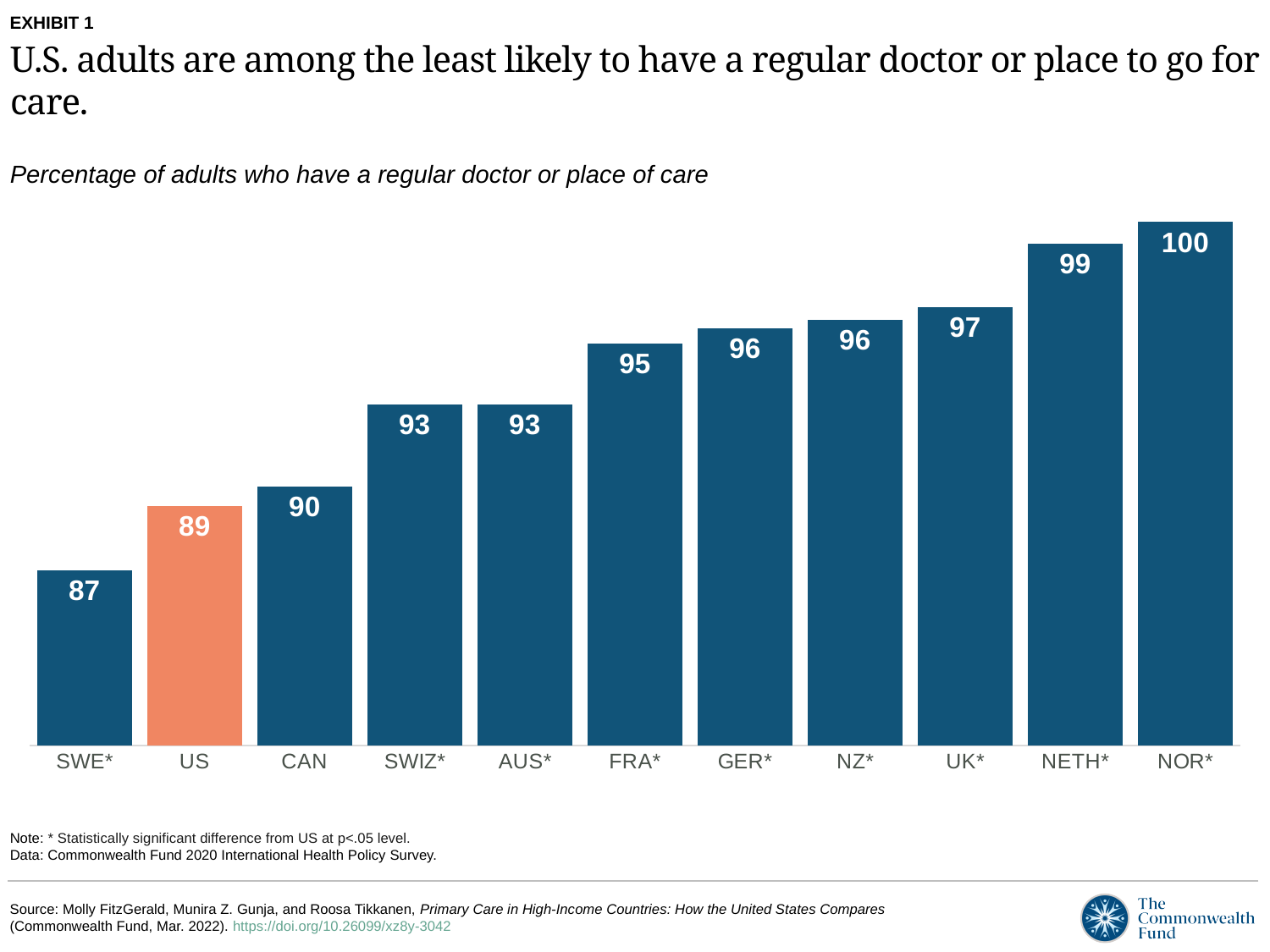
Which is larger, the value for UK* or the value for AUS*? UK* What is the value for SWE*? 87 Which bar is shown in a different colour (orange) from the others? US Which country has the highest value? NOR* What is the difference between the values for NOR* and US? 11 What is the difference between the values for CAN and SWE*? 3 What is the value for US? 89 Do the values rise or fall from left to right along the x axis? Rise What is the value for FRA*? 95 How many countries are shown in the chart? 11 Which country has the lowest value? SWE* What kind of chart is this? Bar chart